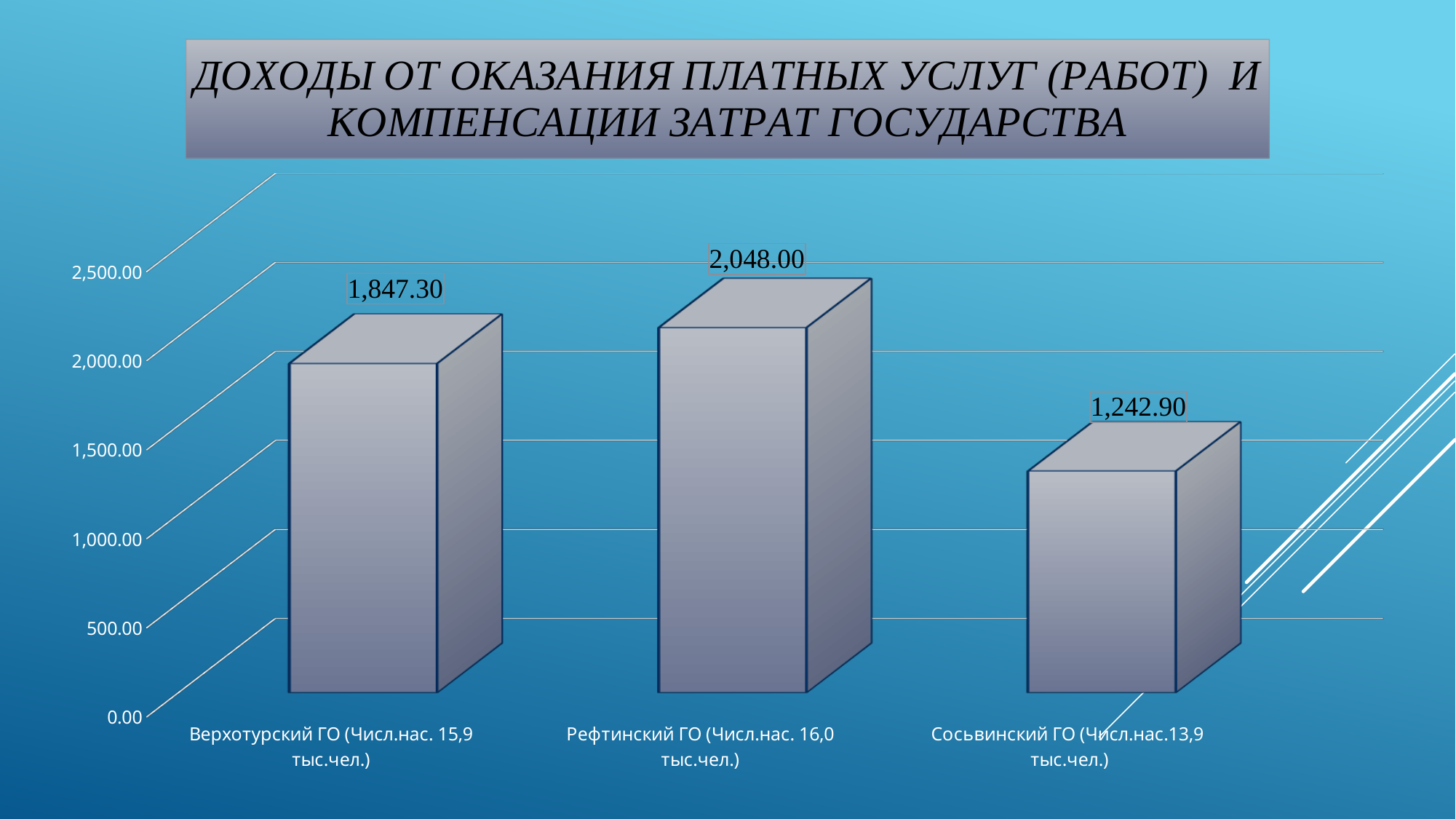
What is the difference between the values for Верхотурский ГО and Сосьвинский ГО? 604.40 What is the population figure given in the label for Сосьвинский ГО? 13,9 тыс.чел. What is the difference between the values for Рефтинский ГО and Верхотурский ГО? 200.70 Which category has the lowest value? Сосьвинский ГО Which is larger, the value for Верхотурский ГО or the value for Сосьвинский ГО? Верхотурский ГО Which category has the highest value? Рефтинский ГО What is the value for Сосьвинский ГО? 1,242.90 What kind of chart is shown on the slide? bar chart What is the value for Верхотурский ГО? 1,847.30 What is the value for Рефтинский ГО? 2,048.00 How many categories are shown on the chart? 3 Is the value for Сосьвинский ГО greater or less than 1,500.00? less